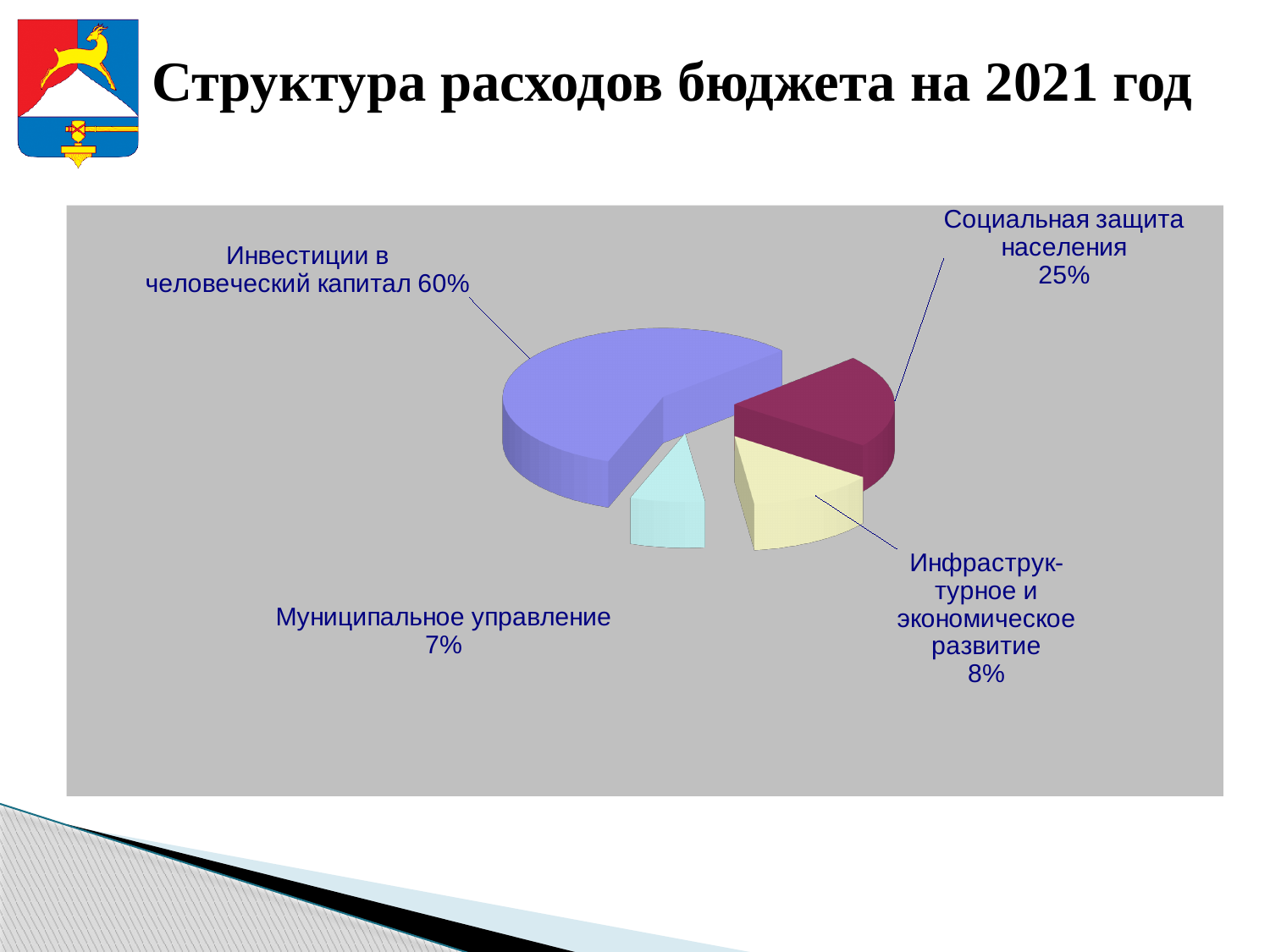
What is the title of the slide? Структура расходов бюджета на 2021 год What share of the budget expenditure goes to Социальная защита населения? 25% What share of the budget expenditure goes to Инфраструктурное и экономическое развитие? 8% What type of chart is shown on the slide? Pie chart What share of the budget expenditure goes to Инвестиции в человеческий капитал? 60% What colour is the slice for Социальная защита населения? Dark red Which category has the largest share of the 2021 budget expenditure? Инвестиции в человеческий капитал Which category has the smallest share of the 2021 budget expenditure? Муниципальное управление What share of the budget expenditure goes to Муниципальное управление? 7% Which is larger: the share for Социальная защита населения or for Инфраструктурное и экономическое развитие? Социальная защита населения What is the difference in percentage points between Инвестиции в человеческий капитал and Социальная защита населения? 35 How many categories are shown in the pie chart? 4